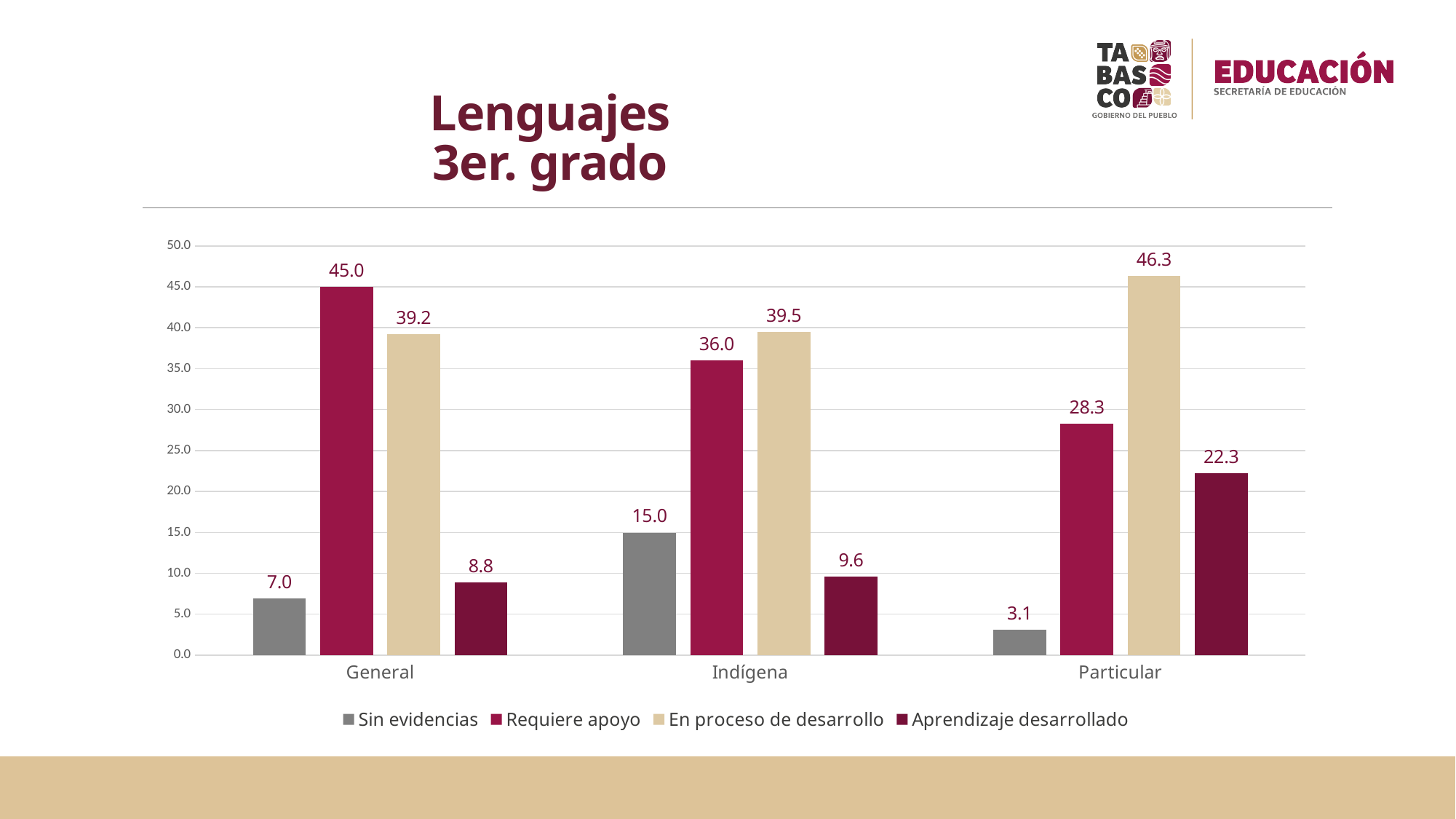
How many categories are shown on the x axis? 3 What kind of chart is shown on the slide? Bar chart Which category has the lowest value for Sin evidencias? Particular Which is larger: En proceso de desarrollo in Indígena or Requiere apoyo in Indígena? En proceso de desarrollo in Indígena What is the title of the slide? Lenguajes 3er. grado What is the value for Sin evidencias in the Indígena category? 15.0 What is the difference between Requiere apoyo in General and Requiere apoyo in Particular? 16.7 What is the value for Aprendizaje desarrollado in the General category? 8.8 How many series does the legend list? 4 Which category has the highest value for Aprendizaje desarrollado? Particular What is the value for En proceso de desarrollo in the Particular category? 46.3 What is the value for Requiere apoyo in the General category? 45.0